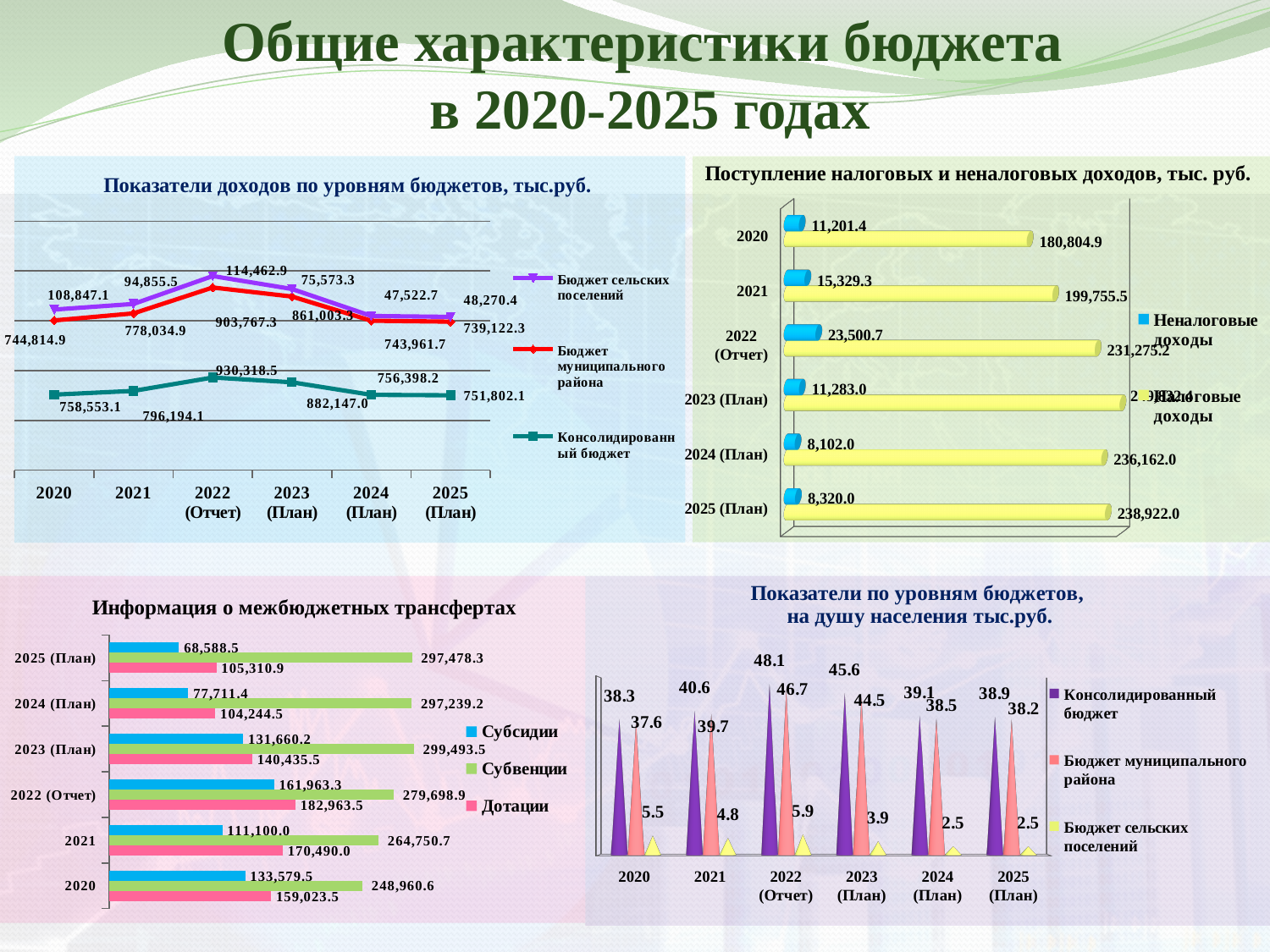
In the chart 'Показатели доходов по уровням бюджетов, тыс.руб.', how many series does the legend list? 3 In the chart 'Информация о межбюджетных трансфертах', which is larger for 2022 (Отчет): Субсидии or Дотации? Дотации In the chart 'Информация о межбюджетных трансфертах', what type of chart is used? Bar chart In the chart 'Показатели по уровням бюджетов, на душу населения тыс.руб.', what is the difference between Консолидированный бюджет and Бюджет муниципального района in 2023 (План)? 1.1 In the chart 'Показатели по уровням бюджетов, на душу населения тыс.руб.', how many years are shown on the x axis? 6 In the chart 'Показатели доходов по уровням бюджетов, тыс.руб.', in which year is the value for Бюджет сельских поселений lowest? 2024 (План) In the chart 'Показатели по уровням бюджетов, на душу населения тыс.руб.', what is the value for Консолидированный бюджет in 2022 (Отчет)? 48.1 In the chart 'Информация о межбюджетных трансфертах', what is the value of Субвенции for 2023 (План)? 299,493.5 In the chart 'Поступление налоговых и неналоговых доходов, тыс. руб.', what is the difference between Налоговые доходы in 2021 and in 2020? 18,950.6 In the chart 'Показатели доходов по уровням бюджетов, тыс.руб.', what is the value for Консолидированный бюджет in 2022 (Отчет)? 930,318.5 In the chart 'Поступление налоговых и неналоговых доходов, тыс. руб.', what is the value of Налоговые доходы for 2025 (План)? 238,922.0 In the chart 'Поступление налоговых и неналоговых доходов, тыс. руб.', in which year is the value of Неналоговые доходы highest? 2022 (Отчет)